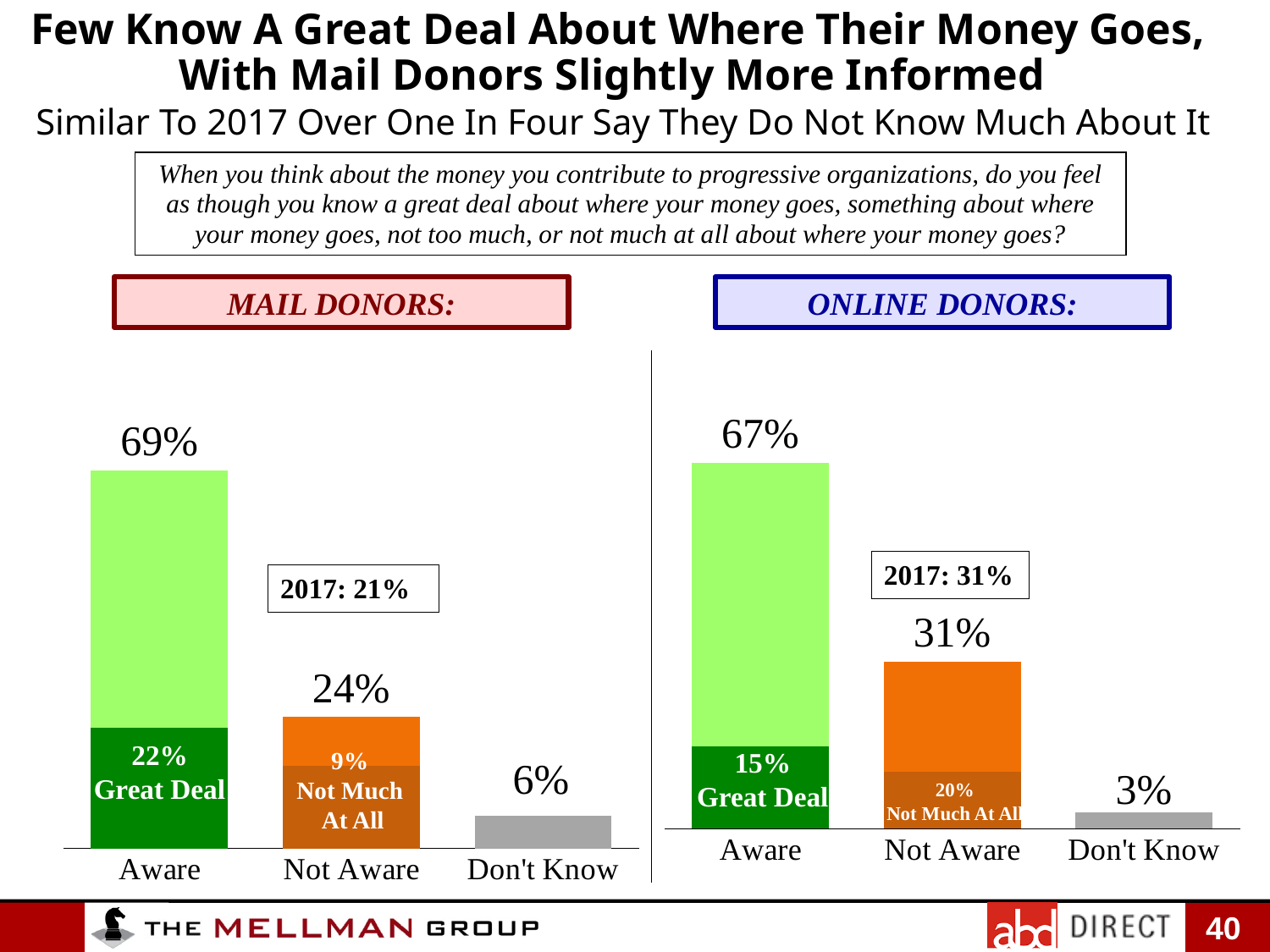
In the Online Donors chart, what percentage are Not Aware? 31% In the Mail Donors chart, what was the Not Aware figure in 2017? 21% Which is larger: the Don't Know value for Mail Donors or the Don't Know value for Online Donors? Mail Donors In the Mail Donors chart, what percentage say they know a Great Deal? 22% How many categories are shown on the x axis of the Online Donors chart? 3 In the Online Donors chart, what percentage say Not Much At All? 20% What kind of chart is used for the Mail Donors data? Bar chart In the Online Donors chart, what is the difference between the Aware and Not Aware percentages? 36% In the Mail Donors chart, which category has the highest value? Aware What is the difference between the Aware percentage for Mail Donors and the Aware percentage for Online Donors? 2% In the Mail Donors chart, what percentage are Aware? 69% In the Online Donors chart, which category has the lowest value? Don't Know